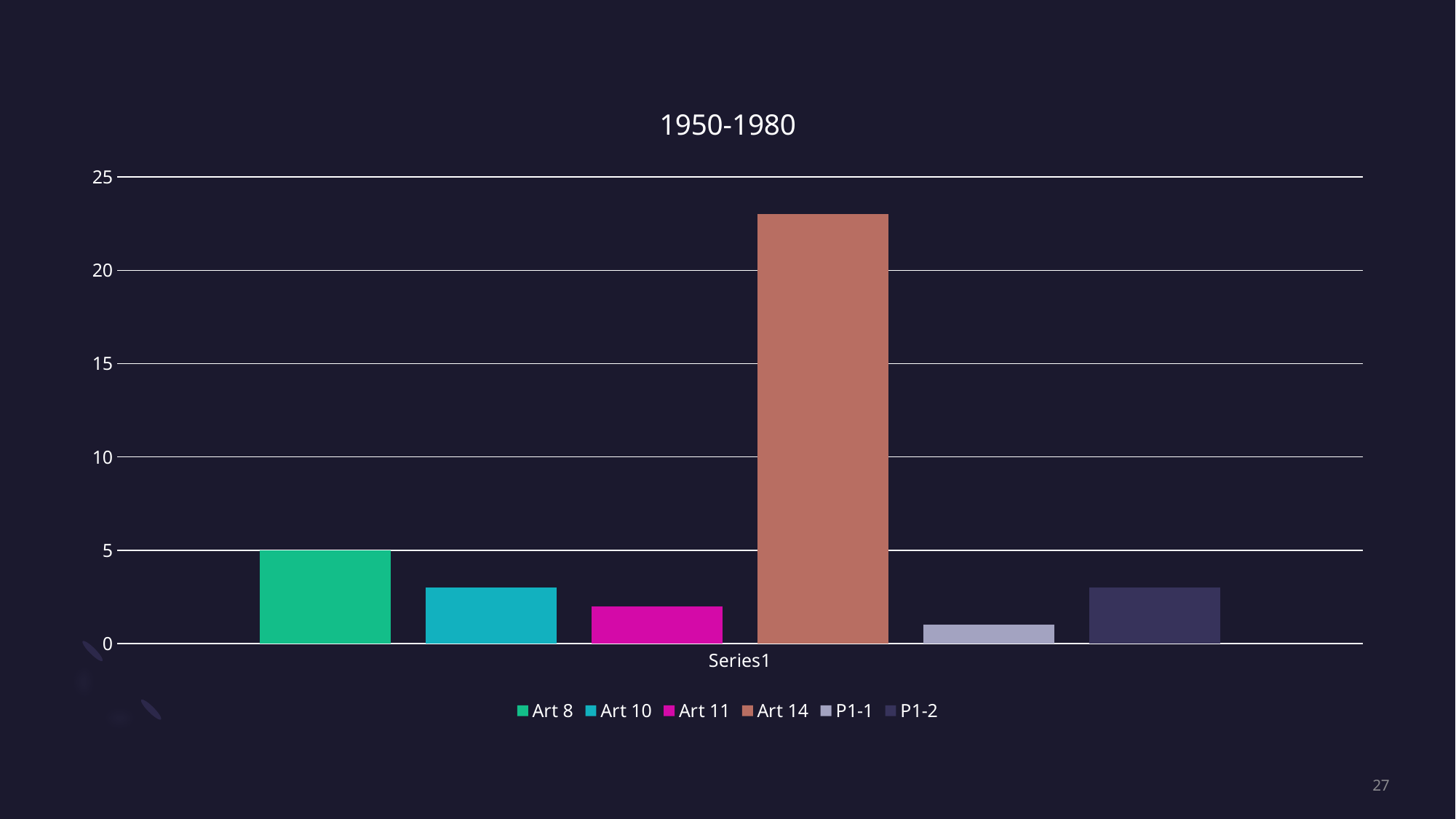
What is the title of the chart? 1950-1980 Is the value for P1-1 greater or less than 5? less How many series does the legend list? 6 Which is larger, the value for Art 14 or the value for Art 8? Art 14 Is the value for Art 14 greater or less than 20? greater Which is larger, the value for Art 8 or the value for Art 10? Art 8 Which series has the highest bar? Art 14 What is the label shown on the x axis under the bars? Series1 Is the value for Art 10 greater or less than 5? less What is the value for Art 8? 5 Which series has the lowest bar? P1-1 What kind of chart is shown on the slide? bar chart